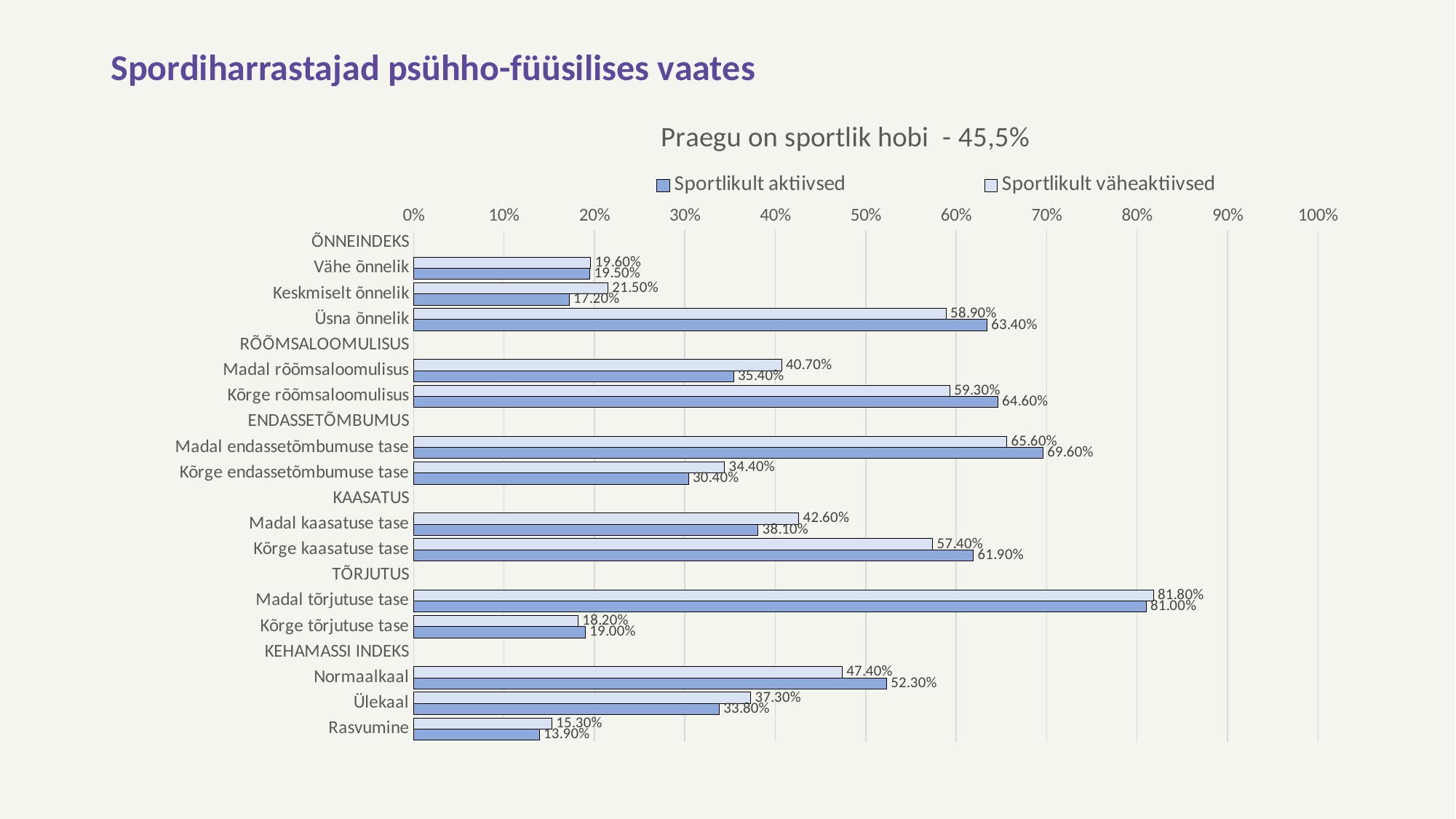
What is the value for Sportlikult aktiivsed in the Rasvumine category? 13.90% What is the value for Sportlikult väheaktiivsed in the Madal rõõmsaloomulisus category? 40.70% In the Kõrge endassetõmbumuse tase category, which series has the larger value: Sportlikult aktiivsed or Sportlikult väheaktiivsed? Sportlikult väheaktiivsed What kind of chart is shown on the slide? Bar chart What is the difference between Sportlikult aktiivsed and Sportlikult väheaktiivsed in the Normaalkaal category? 4.90% Which category has the lowest value for Sportlikult väheaktiivsed? Rasvumine What is the title of the chart? Praegu on sportlik hobi - 45,5% Which category has the highest value for Sportlikult aktiivsed? Madal tõrjutuse tase What is the value for Sportlikult aktiivsed in the Üsna õnnelik category? 63.40% Is the value for Sportlikult aktiivsed in the Madal endassetõmbumuse tase category greater or less than 60%? greater What is the value for Sportlikult väheaktiivsed in the Kõrge kaasatuse tase category? 57.40% How many series does the chart legend list? 2